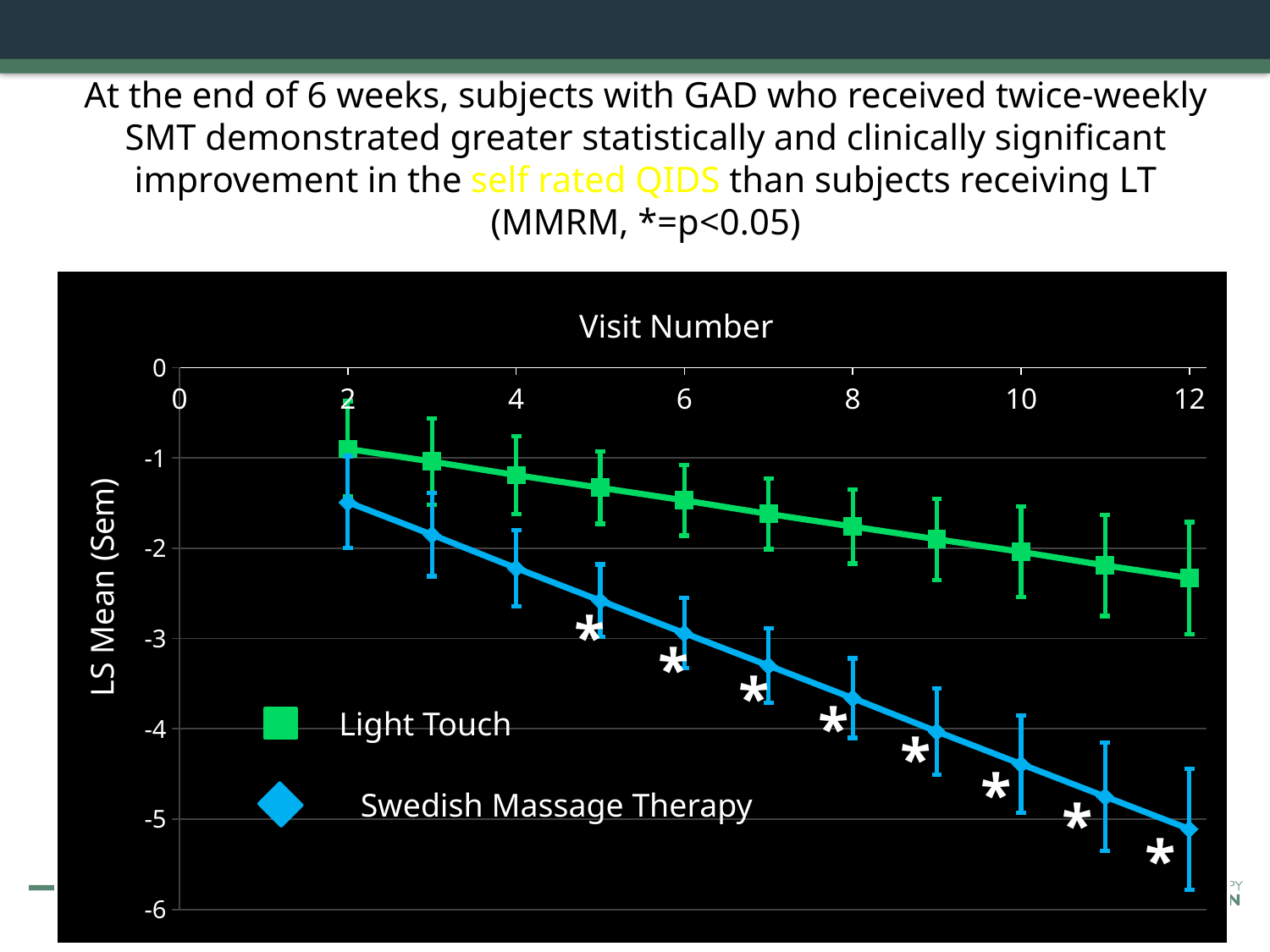
At visit 12, which series has the lower (more negative) value, Light Touch or Swedish Massage Therapy? Swedish Massage Therapy Do the values for Swedish Massage Therapy rise or fall as the visit number increases? fall Is the value for Swedish Massage Therapy at visit 8 greater or less than -3? less Do the values for Light Touch rise or fall as the visit number increases? fall What is the label of the y axis? LS Mean (Sem) Is the value for Light Touch at visit 2 greater or less than -1? greater Is the value for Swedish Massage Therapy at visit 12 greater or less than -5? less What are the two series named in the legend? Light Touch and Swedish Massage Therapy How many series does the legend list? 2 Which series reaches the lowest value on the chart? Swedish Massage Therapy What kind of chart is shown on the slide? line chart